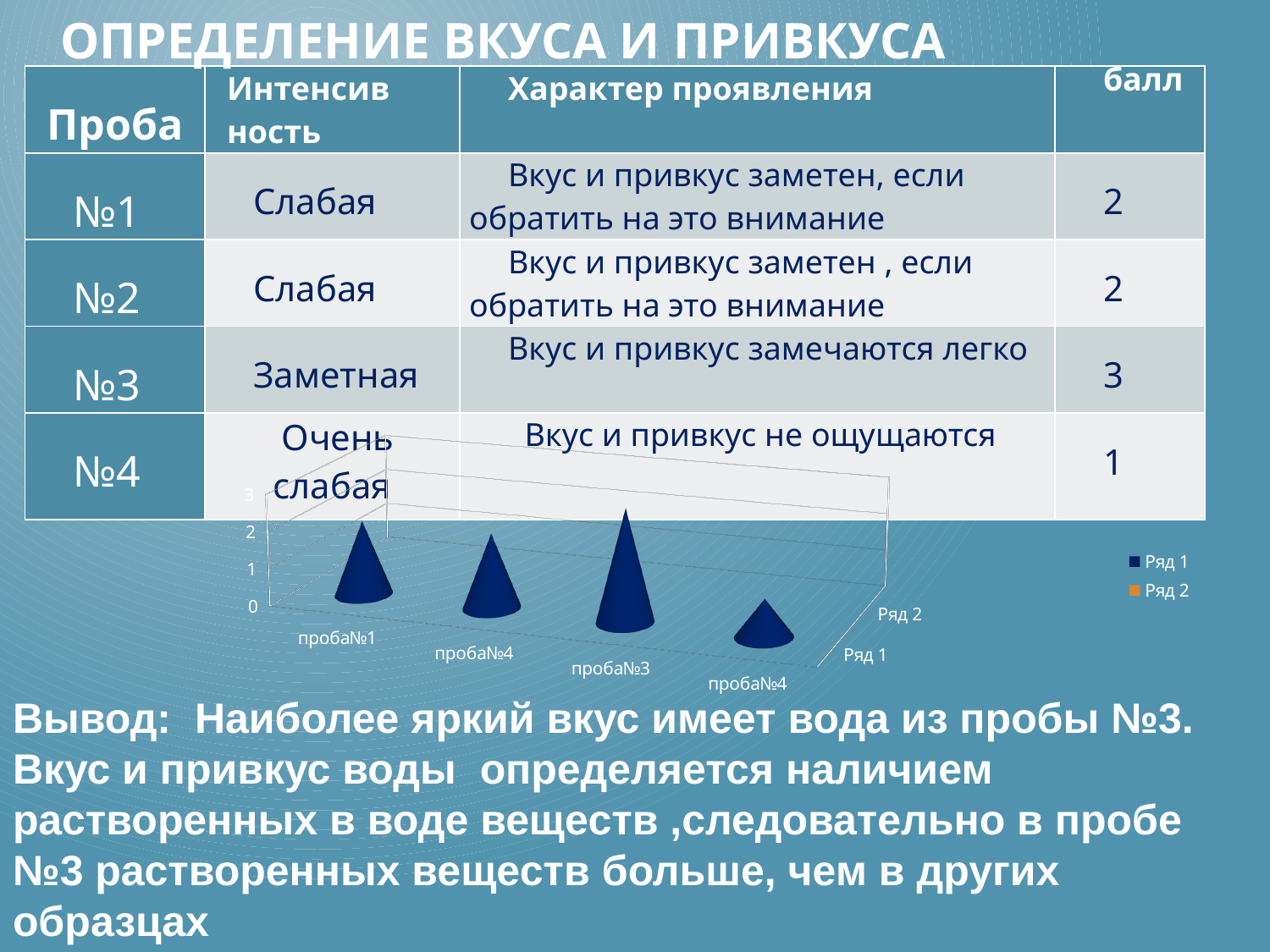
Which category has the tallest bar in the chart? проба№3 How many categories are plotted along the x axis of the chart? 4 Is the value for the rightmost category (проба№4) greater or less than 2? less How many series does the chart legend list? 2 Which category has the shortest bar in the chart? проба№4 Which is larger, the value for проба№3 or the value for проба№1? проба№3 Is the value for проба№1 greater or less than 1? greater Which is larger, the value for проба№1 or the value for the rightmost category (проба№4)? проба№1 Is the value for проба№3 greater or less than 2? greater What is the highest tick value shown on the chart's vertical axis? 3 What are the two entries in the chart legend? Ряд 1, Ряд 2 What kind of chart is shown on the slide? bar chart